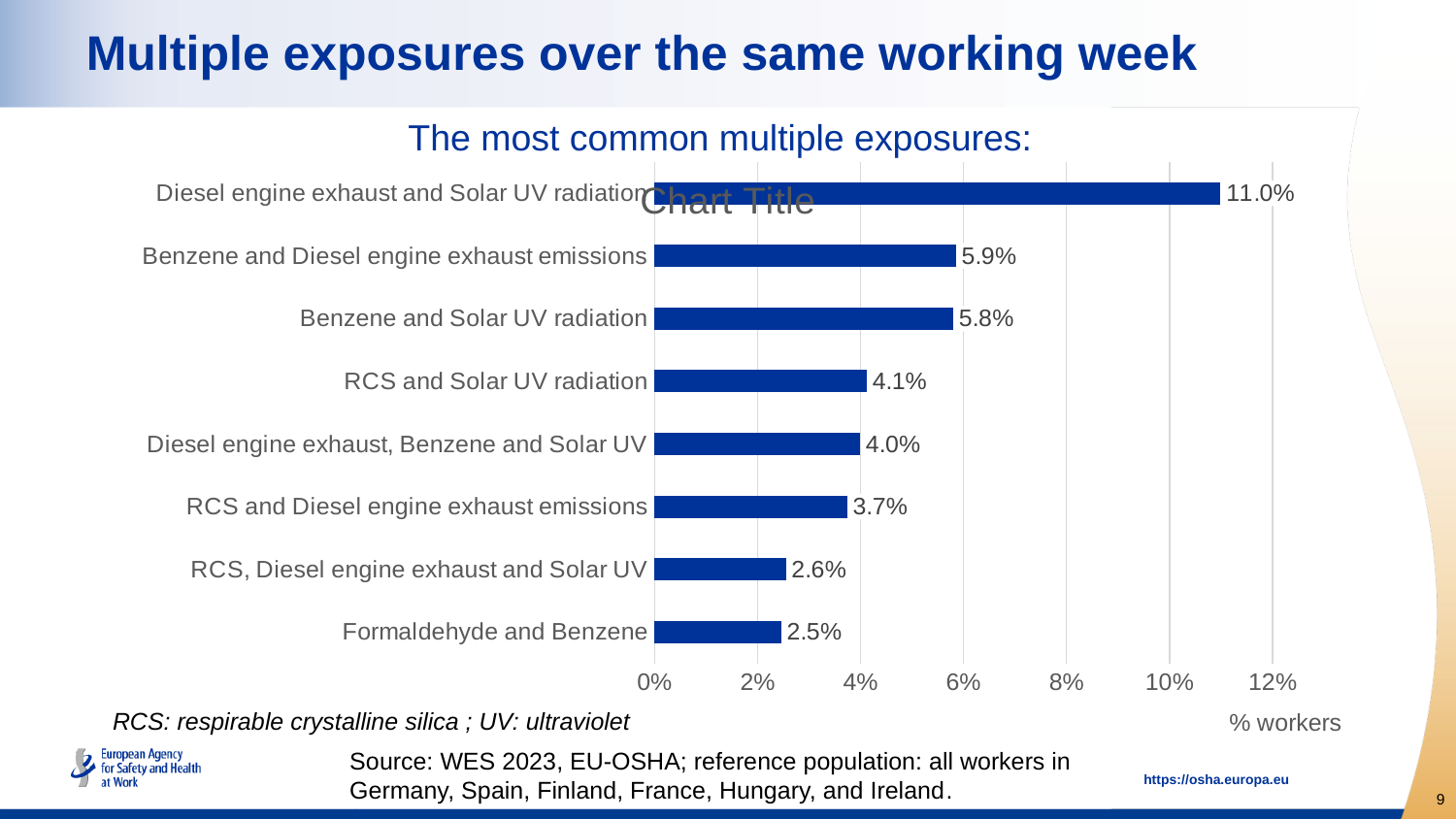
What is the difference between the values for Diesel engine exhaust and Solar UV radiation and Benzene and Diesel engine exhaust emissions? 5.1% Is the value for Diesel engine exhaust, Benzene and Solar UV greater or less than 6%? less Which multiple exposure has the highest percentage of workers? Diesel engine exhaust and Solar UV radiation What percentage of workers are exposed to both Diesel engine exhaust and Solar UV radiation? 11.0% What type of chart is shown on the slide? Bar chart Which is larger: the value for Benzene and Solar UV radiation or the value for RCS and Solar UV radiation? Benzene and Solar UV radiation What is the value for Formaldehyde and Benzene? 2.5% What is the value for RCS and Solar UV radiation? 4.1% What is the difference between the values for RCS and Diesel engine exhaust emissions and RCS, Diesel engine exhaust and Solar UV? 1.1% What unit is indicated for the values on the horizontal axis? % workers How many multiple exposure categories are shown in the chart? 8 Which multiple exposure has the lowest percentage of workers? Formaldehyde and Benzene